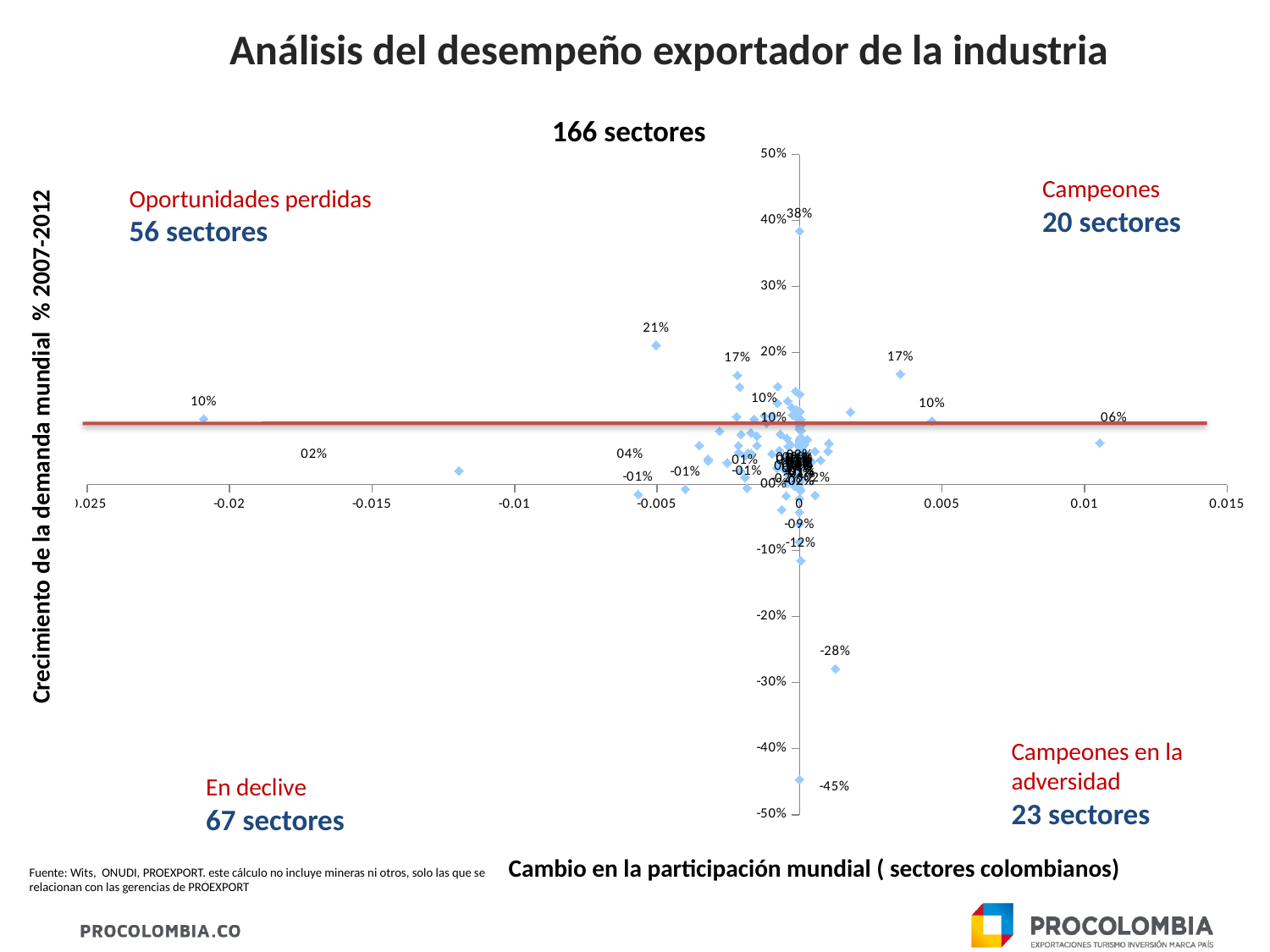
Which quadrant has the most sectors? En declive What is the highest labelled value on the chart? 38% How many sectors are in the 'Campeones' quadrant? 20 sectores How many sectors are in the 'Campeones en la adversidad' quadrant? 23 sectores Which is larger, the point labelled 38% or the point labelled 21%? 38% How many sectors are in the 'En declive' quadrant? 67 sectores What kind of chart is shown on the slide? scatter chart How many sectors are in the 'Oportunidades perdidas' quadrant? 56 sectores What is the difference between the highest labelled value (38%) and the lowest labelled value (-45%)? 83 percentage points What is the label of the vertical axis? Crecimiento de la demanda mundial % 2007-2012 What is the lowest labelled value on the chart? -45% What is the title of the chart? 166 sectores